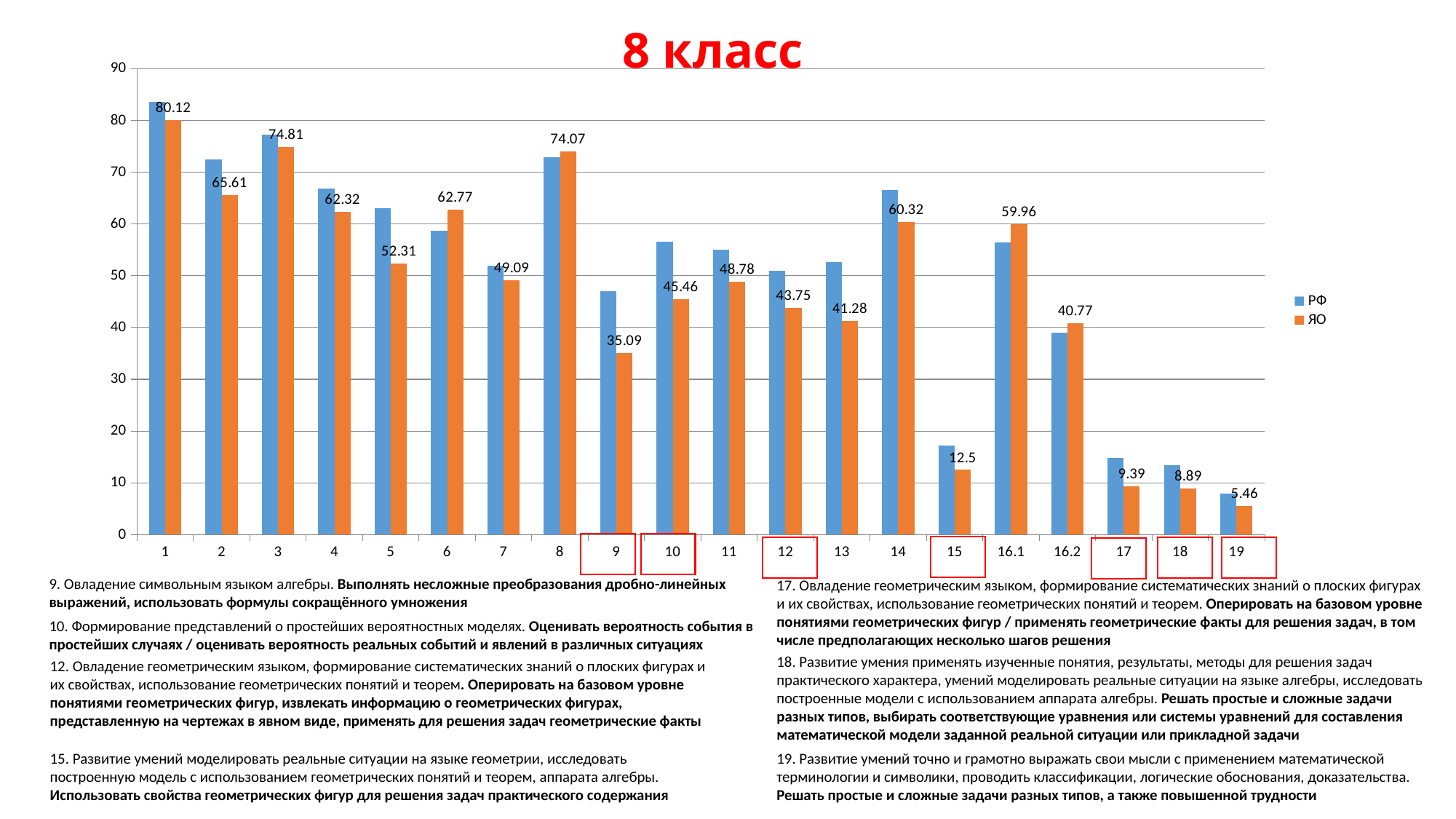
Which category has the highest ЯО value? 1 For category 6, which series has the larger value, РФ or ЯО? ЯО What type of chart is shown on the slide? bar chart How many series does the legend list? 2 What is the ЯО value for category 16.2? 40.77 Which category has the lowest ЯО value? 19 What is the ЯО value for category 1? 80.12 What is the ЯО value for category 15? 12.5 Is the РФ value for category 16.2 greater or less than 40? less How many categories are shown on the x axis? 20 What is the difference between the ЯО values for category 1 and category 19? 74.66 Is the РФ value for category 1 greater or less than 80? greater